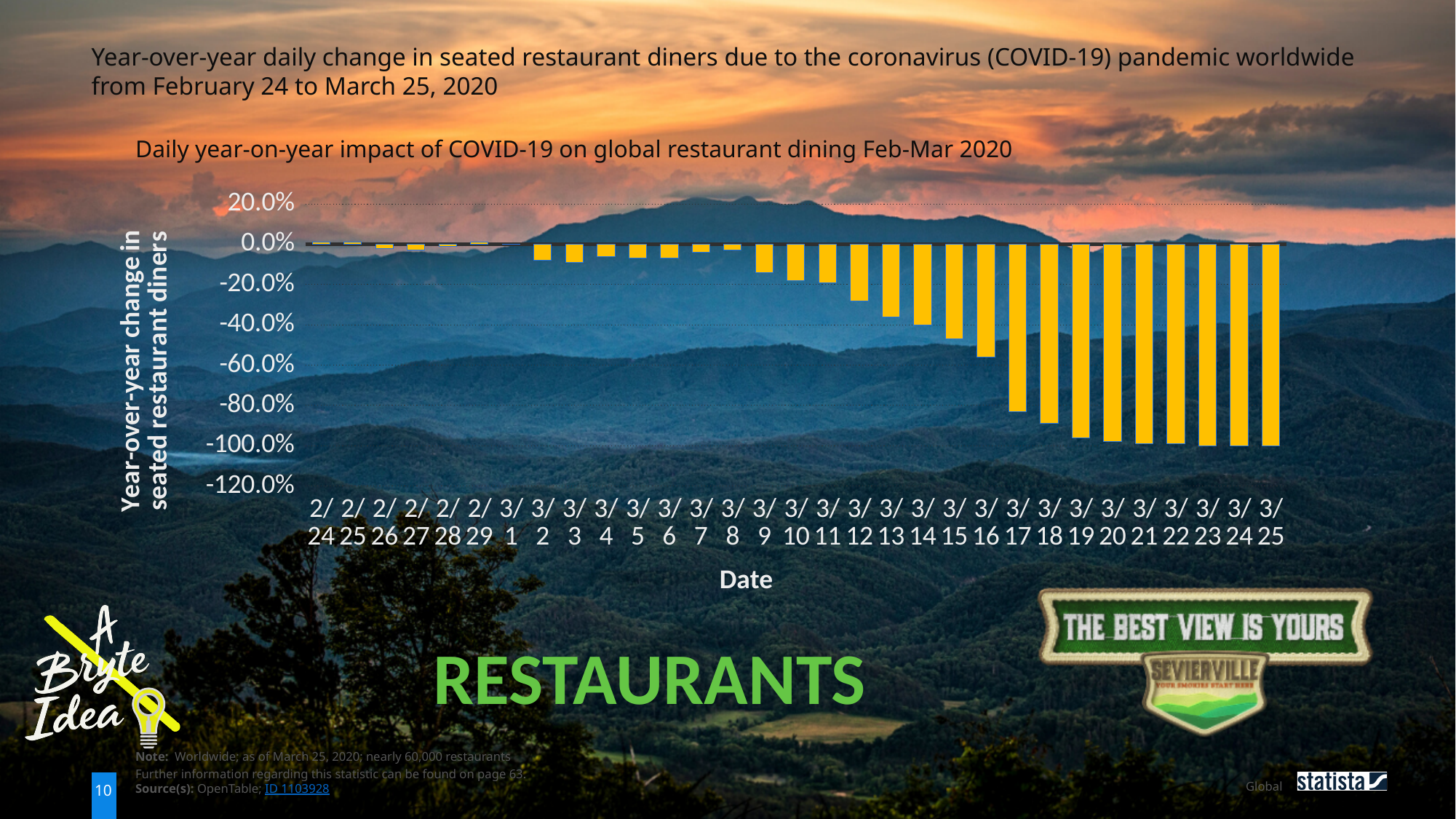
What is the title of the chart? Daily year-on-year impact of COVID-19 on global restaurant dining Feb-Mar 2020 What is the label of the vertical axis of the chart? Year-over-year change in seated restaurant diners Which date has the larger (less negative) value, 3/13 or 3/17? 3/13 Is the value for 3/15 greater or less than -40.0%? less Is the value for 3/12 greater or less than -20.0%? less Do the values generally rise or fall as the dates move from 2/24 to 3/25? fall Which date has the larger (less negative) value, 3/9 or 3/16? 3/9 What kind of chart is shown on the slide? bar chart How many dates are plotted on the x axis of the chart? 31 Is the value for 3/16 greater or less than -40.0%? less